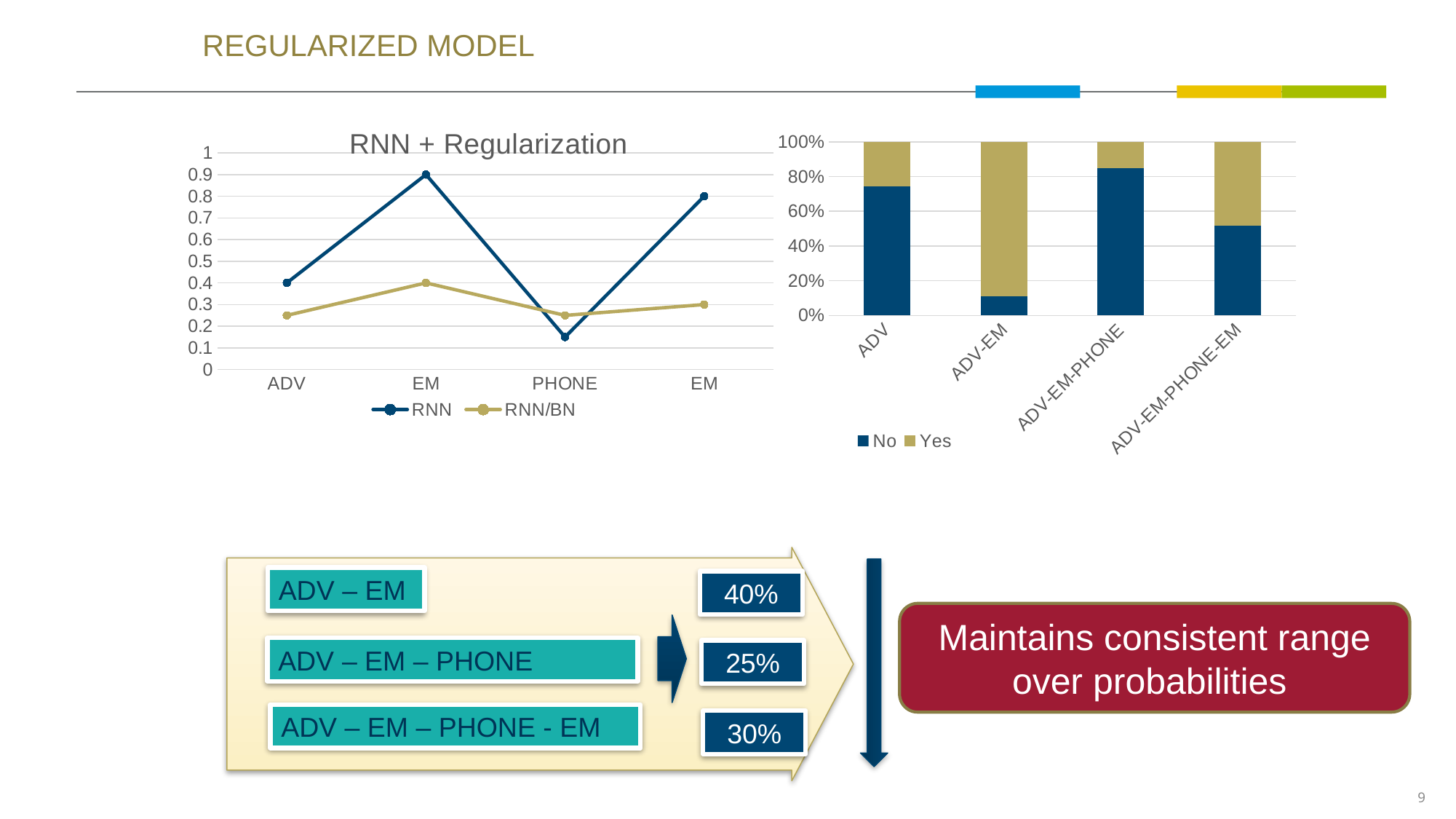
What kind of chart is the 'RNN + Regularization' chart on the left? line chart What kind of chart is the chart on the right with the No/Yes legend? stacked bar chart In the stacked bar chart on the right, is the 'No' share for ADV-EM greater or less than 20%? less In the stacked bar chart on the right, which category has the largest 'Yes' share? ADV-EM In the stacked bar chart on the right, which category has the largest 'No' share? ADV-EM-PHONE In the 'RNN + Regularization' chart, which series is higher at PHONE, RNN or RNN/BN? RNN/BN How many categories are shown on the x axis of the stacked bar chart on the right? 4 In the 'RNN + Regularization' chart, which category has the highest RNN value? EM (the first EM) In the 'RNN + Regularization' chart, is the RNN value for PHONE greater or less than 0.2? less How many series does the legend of the 'RNN + Regularization' chart list? 2 In the 'RNN + Regularization' chart, what is the RNN value for ADV? 0.4 In the 'RNN + Regularization' chart, which category has the lowest RNN value? PHONE